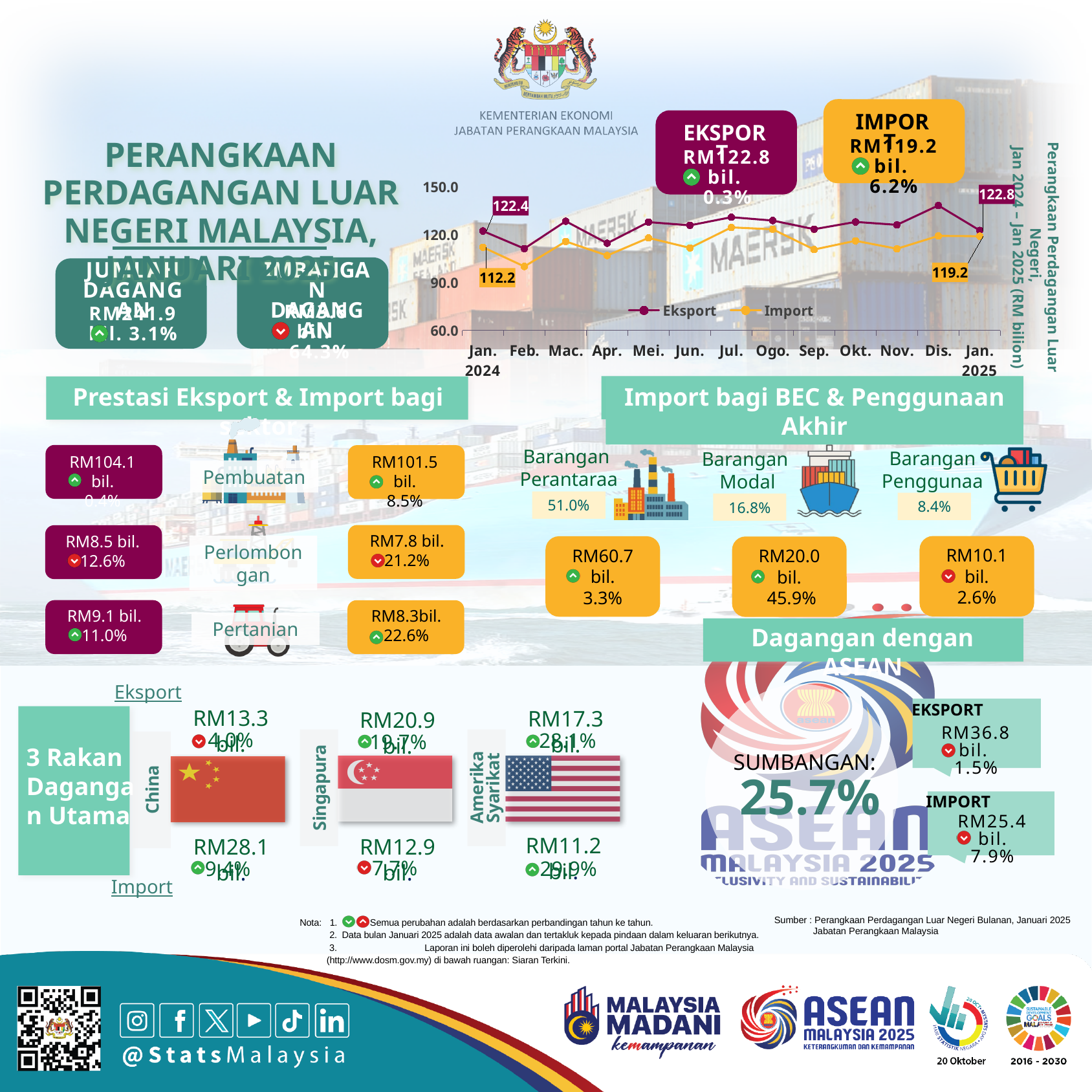
What is the Import value for Jan 2024 in the line chart? 112.2 In the line chart, is the Import value for Feb 2024 greater or less than 120.0? less What is the Import value for Jan 2025 in the line chart? 119.2 In the line chart, does the Import series rise or fall from Jan 2024 to Jan 2025? rise What type of chart is used to show Eksport and Import from Jan 2024 to Jan 2025? line chart How many series does the legend of the line chart list? 2 In the line chart, what is the difference between Eksport and Import in Jan 2024? 10.2 How many months are plotted along the x axis of the line chart? 13 In the line chart, what is the difference between Eksport and Import in Jan 2025? 3.6 What is the Eksport value for Jan 2025 in the line chart? 122.8 What is the Eksport value for Jan 2024 in the line chart? 122.4 In the line chart, which is larger in Jan 2025, Eksport or Import? Eksport